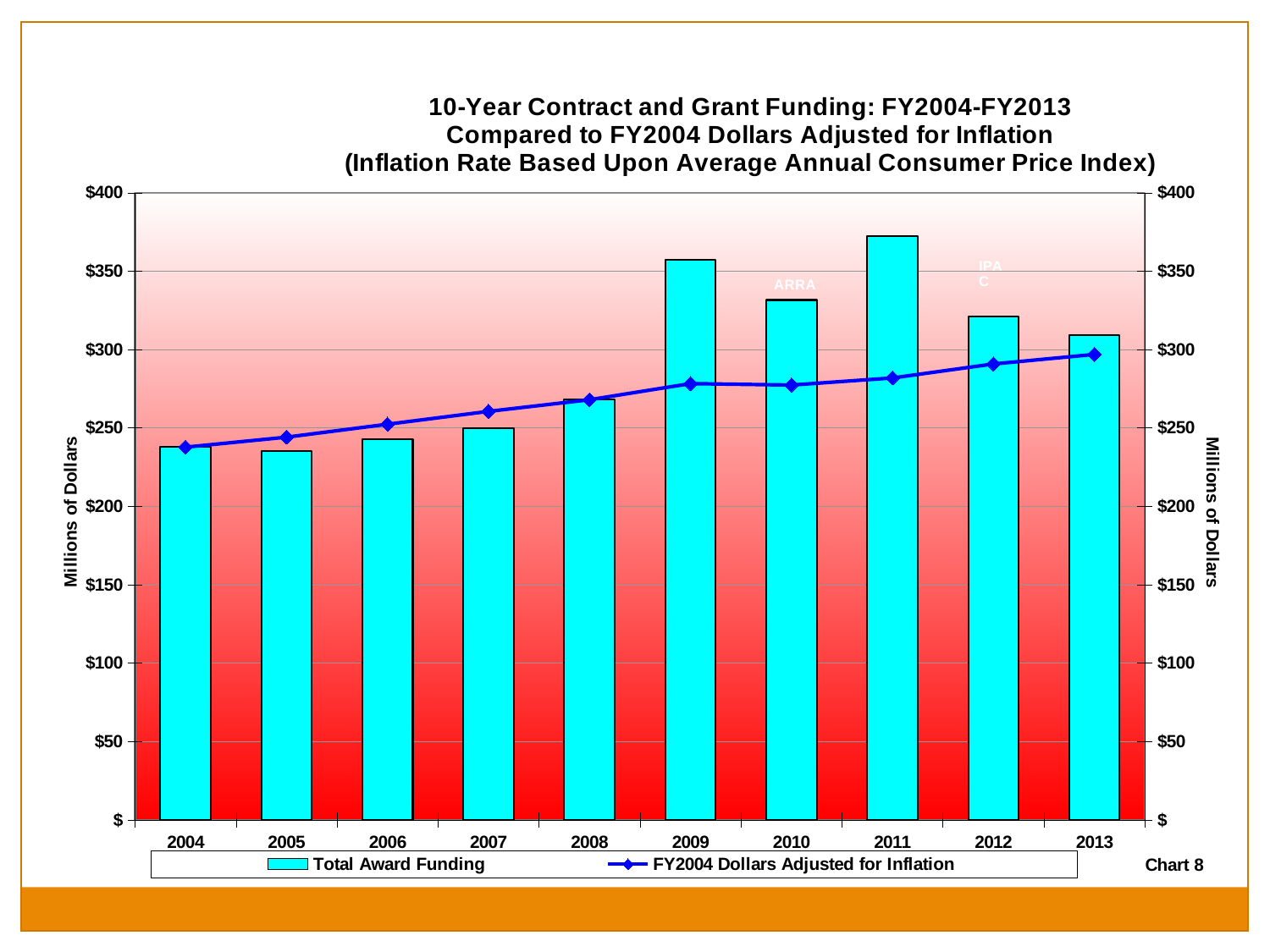
Is the FY2004 Dollars Adjusted for Inflation value for 2004 greater or less than $250? less Is the Total Award Funding for 2005 greater or less than $250? less Is the Total Award Funding for 2012 greater or less than $300? greater What label is printed above the 2010 bar? ARRA Does the FY2004 Dollars Adjusted for Inflation line rise or fall from 2004 to 2013? rise What kind of chart is shown on the slide? A bar chart with a line series overlaid What is the unit shown on the y axis? Millions of Dollars Which year has the larger Total Award Funding bar, 2009 or 2010? 2009 How many fiscal years are plotted along the x axis? 10 How many series does the legend list? 2 Which year has the highest Total Award Funding bar? 2011